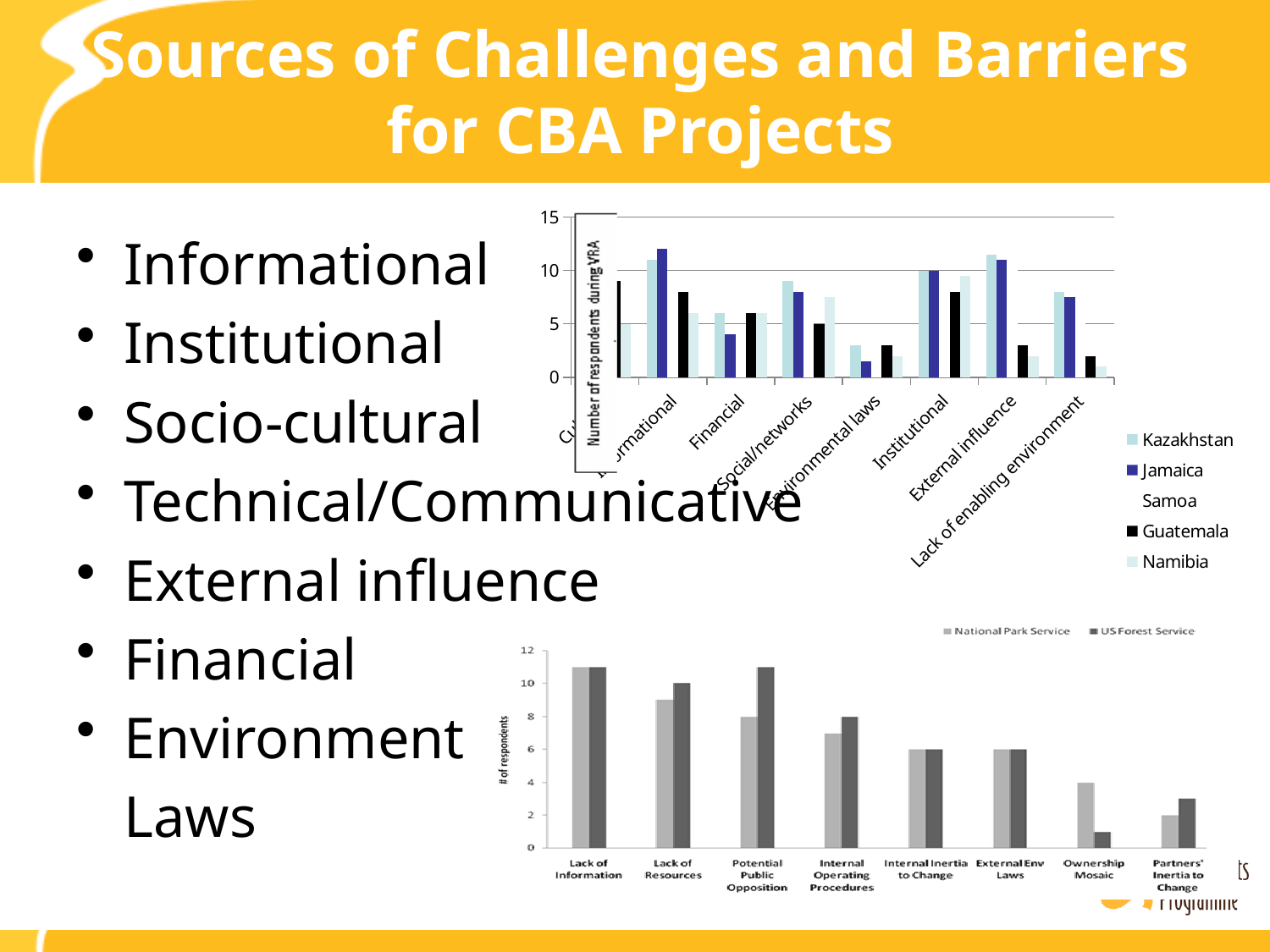
In the top chart, is the Jamaica value for Informational greater or less than 10? greater In the bottom chart, which category has the lowest US Forest Service value? Ownership Mosaic In the bottom chart, how many categories are shown on the x axis? 8 What is the y-axis label of the top chart? Number of respondents during VRA In the bottom chart, what is the National Park Service value for Internal Inertia to Change? 6 In the bottom chart, how many series does the legend list? 2 In the bottom chart, what is the National Park Service value for Ownership Mosaic? 4 In the top chart, for External influence, which is larger, the Jamaica value or the Guatemala value? Jamaica In the top chart, how many series does the legend list? 5 What kind of chart is the bottom chart on the slide? bar chart In the bottom chart, for Ownership Mosaic, which series has the larger value, National Park Service or US Forest Service? National Park Service In the bottom chart, is the National Park Service value for Lack of Information greater or less than 10? greater